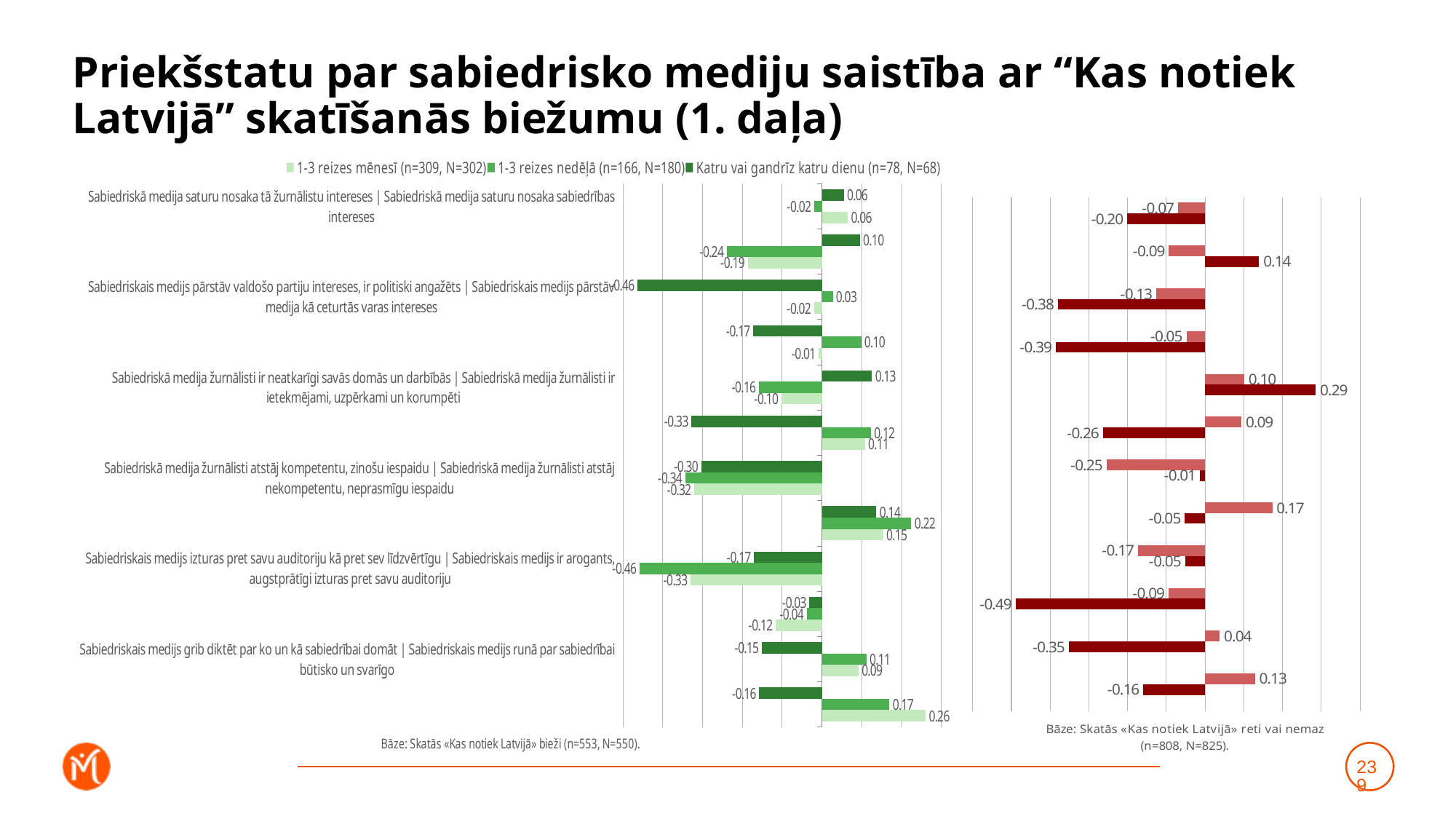
In the right chart, in the second group from the top, which is larger: the light red bar (-0.09) or the dark red bar (0.14)? the dark red bar (0.14) In the right chart, what is the lowest value printed on any bar? -0.49 In the left chart, what is the value of the dark green bar in the topmost group of bars? 0.06 What kind of chart is shown on the left side of the slide? bar chart How many series does the legend of the left chart list? 3 In the left chart, what is the highest value printed on any bar? 0.26 In the left chart, what is the value of the dark green bar for the category 'Sabiedriskais medijs pārstāv valdošo partiju intereses, ir politiski angažēts'? -0.46 What base note is printed under the left chart? Bāze: Skatās «Kas notiek Latvijā» bieži (n=553, N=550). In the left chart, what is the difference between the light green bar (0.26) and the medium green bar (0.17) in the bottom group? 0.09 In the right chart, what is the highest value printed on any bar? 0.29 In the right chart, what is the value of the dark red bar in the bottom group of bars? -0.16 What is the first legend entry of the left chart? 1-3 reizes mēnesī (n=309, N=302)